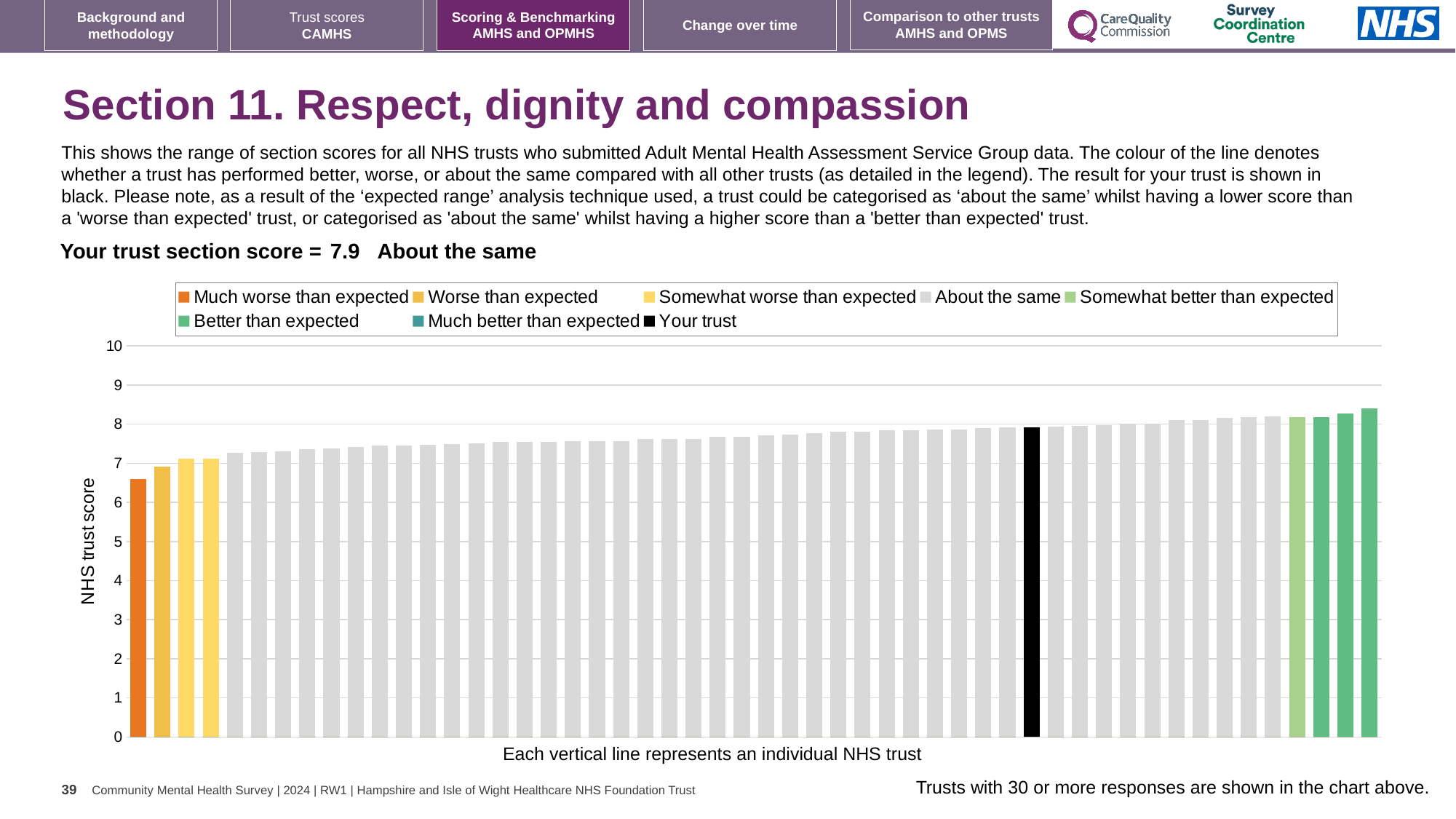
What category is described as 'About the same' on the slide? Your trust section score How many bars are shown in the 'Much worse than expected' colour? 1 Is the value of the tallest bar in the chart greater or less than 8? greater How many entries does the chart legend list? 8 What colour is used for the 'Your trust' bar in the chart? black Is the value of the 'Your trust' bar greater or less than 7? greater Is the value of the 'Much worse than expected' bar greater or less than 7? less Do the bar values rise or fall moving from left to right along the x axis? rise What type of chart is shown on the slide? bar chart What is the section score for your trust shown on the slide? 7.9 What is the label on the vertical axis of the chart? NHS trust score Which is larger: the 'Your trust' bar or the 'Much worse than expected' bar? Your trust